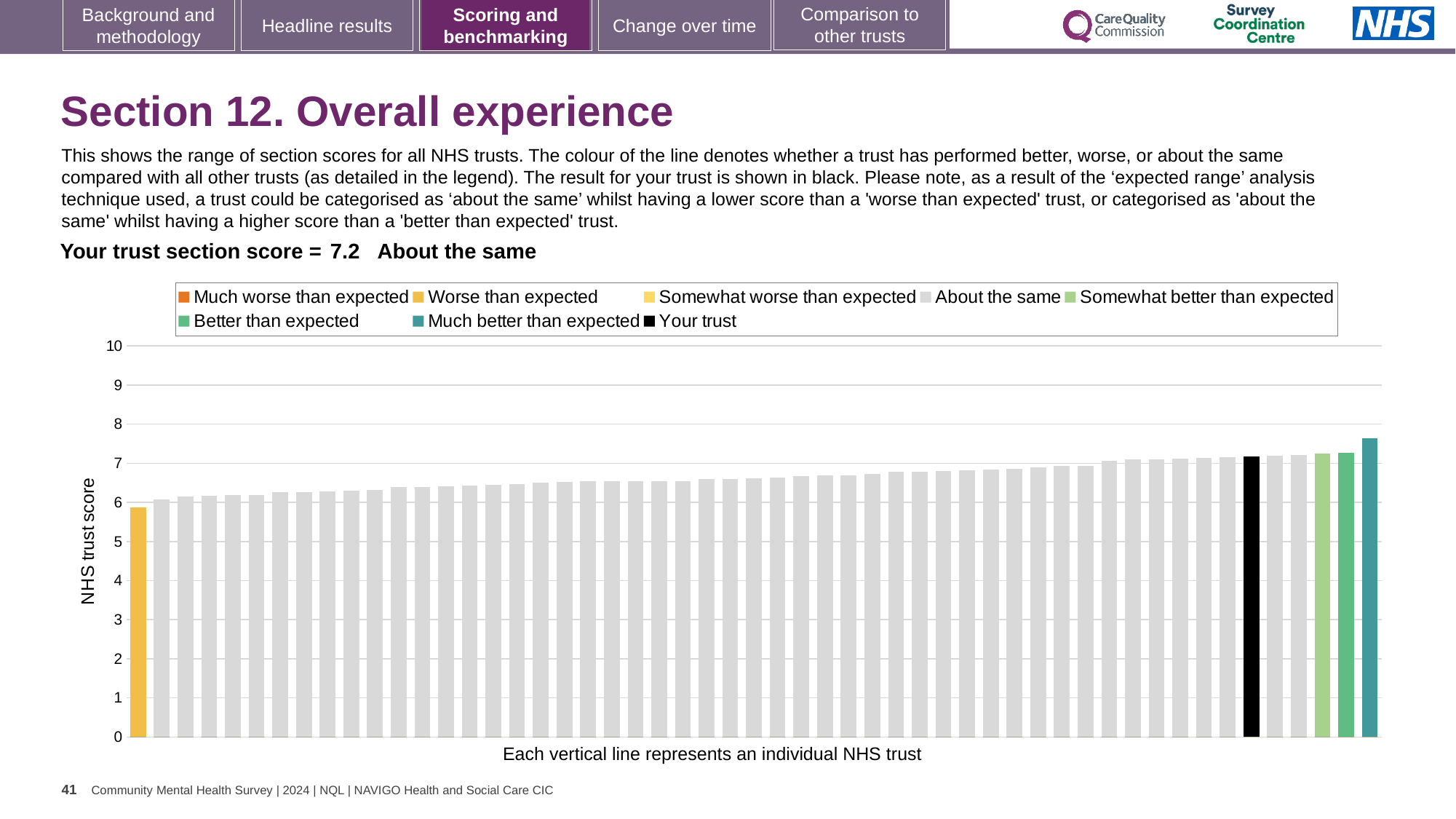
Is the 'Your trust' bar higher or lower than the 'Much better than expected' bar? lower What kind of chart is shown on the slide? bar chart What is the label on the vertical axis of the chart? NHS trust score How many entries does the chart legend list? 8 Is the value of the 'Your trust' bar greater or less than 7? greater Which legend category does the highest bar in the chart belong to? Much better than expected Which legend category does the lowest bar in the chart belong to? Worse than expected What colour is the bar representing your trust? black Do the bar values rise or fall from left to right along the x axis? rise What is the section score for your trust shown on the slide? 7.2 Is the value of the shortest bar (Worse than expected) greater or less than 5? greater Is the value of the tallest bar (Much better than expected) greater or less than 8? less